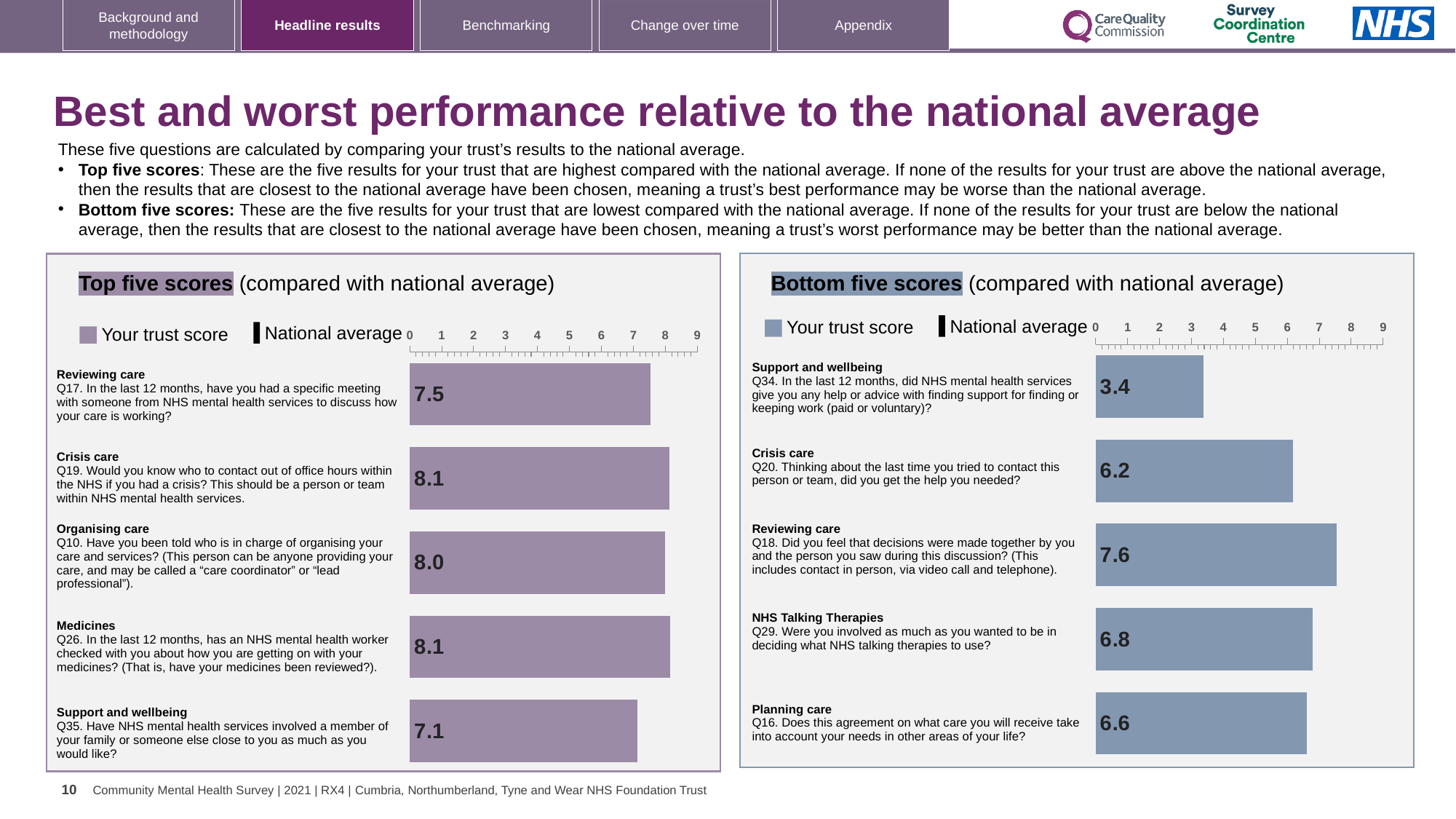
In the Bottom five scores chart, what is the trust score for Q16 (Planning care)? 6.6 In the Bottom five scores chart, what is the difference between the trust scores for Q18 and Q34? 4.2 What kind of chart is used in the Top five scores panel? Bar chart In the Bottom five scores chart, what is the trust score for Q34 (Support and wellbeing)? 3.4 In the Top five scores chart, what is the trust score for Q10 (Organising care)? 8.0 In the Top five scores chart, which question has the lowest trust score? Q35 (Support and wellbeing) In the Top five scores chart, how many questions are plotted? 5 In the Top five scores chart, what is the trust score for Q17 (Reviewing care)? 7.5 In the Bottom five scores chart, which has the larger trust score, Q20 or Q29? Q29 In the Bottom five scores chart, which question has the highest trust score? Q18 (Reviewing care) In the Top five scores chart, what is the difference between the trust scores for Q19 and Q35? 1.0 In the Bottom five scores chart, which question has the lowest trust score? Q34 (Support and wellbeing)